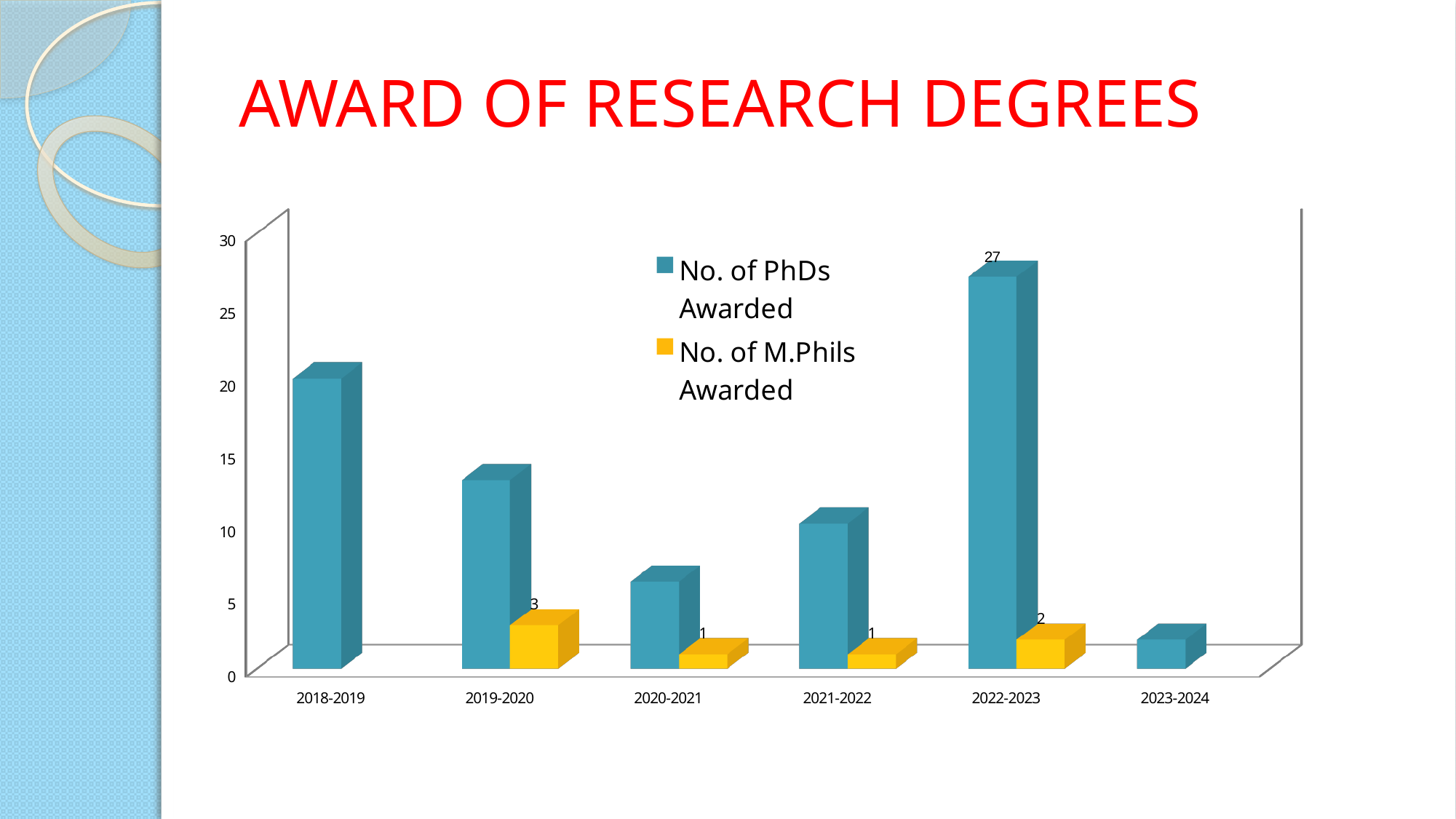
In which year was the number of PhDs awarded lowest? 2023-2024 How many academic years are shown on the x axis? 6 Which year had more PhDs awarded, 2018-2019 or 2019-2020? 2018-2019 Is the number of PhDs awarded in 2018-2019 greater or less than 15? greater Is the number of PhDs awarded in 2023-2024 greater or less than 5? less How many M.Phils were awarded in 2022-2023? 2 How many PhDs were awarded in 2022-2023? 27 How many M.Phils were awarded in 2019-2020? 3 How many series does the legend list? 2 What is the difference between the number of M.Phils awarded in 2019-2020 and in 2022-2023? 1 What kind of chart is shown on the slide? bar chart In which year was the number of PhDs awarded highest? 2022-2023